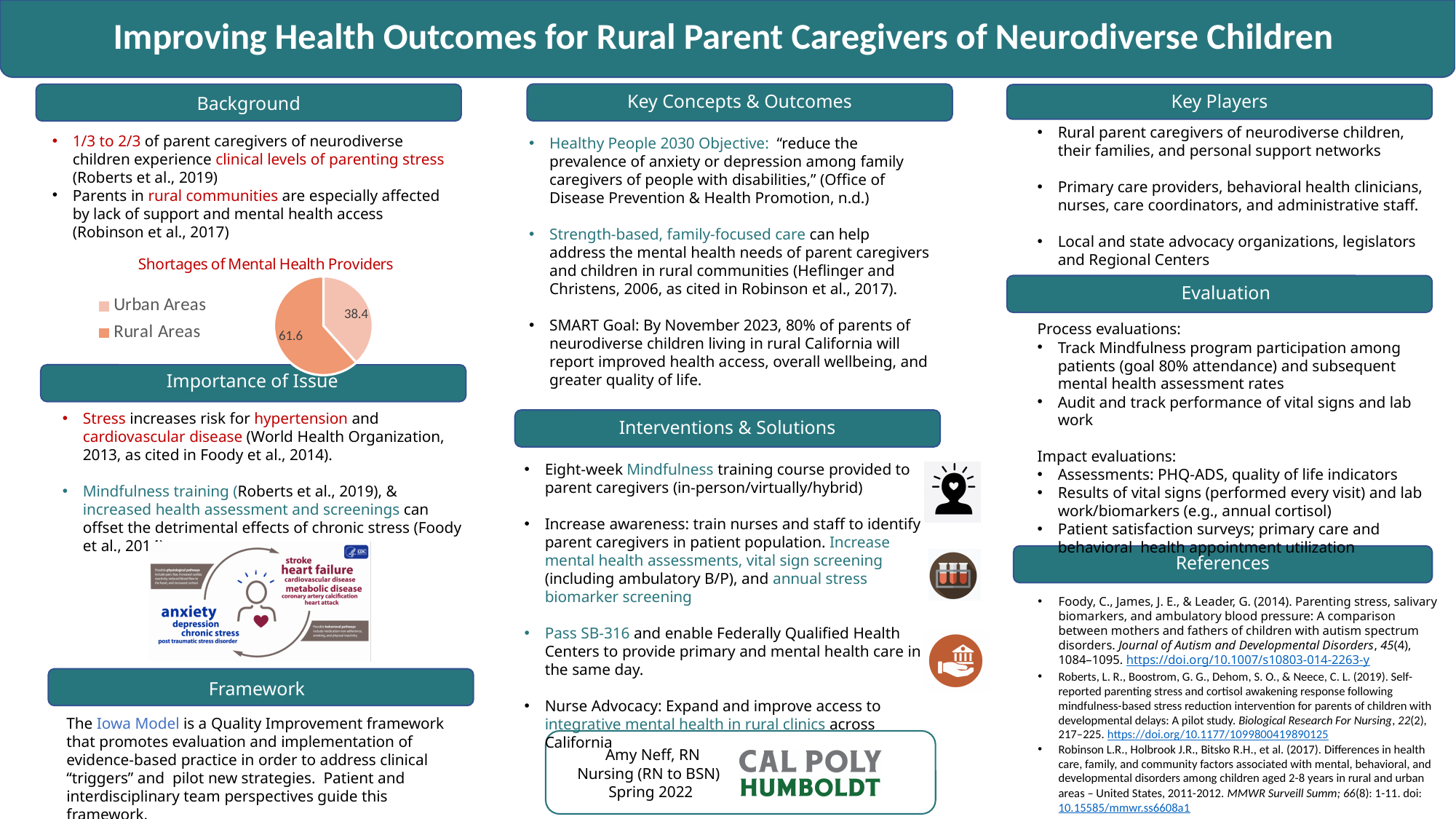
In the "Shortages of Mental Health Providers" pie chart, what is the difference between the Rural Areas value and the Urban Areas value? 23.2 What is the total of the two values shown in the "Shortages of Mental Health Providers" pie chart? 100 In the "Shortages of Mental Health Providers" pie chart, is the value for Rural Areas larger or smaller than the value for Urban Areas? larger In the "Shortages of Mental Health Providers" pie chart, what is the value for Urban Areas? 38.4 Which legend entry in the "Shortages of Mental Health Providers" pie chart is shown in the darker orange colour? Rural Areas What is the title of the pie chart on the slide? Shortages of Mental Health Providers How many entries does the legend of the "Shortages of Mental Health Providers" pie chart list? 2 What kind of chart is shown under the heading "Shortages of Mental Health Providers"? pie chart Which category has the smallest slice in the "Shortages of Mental Health Providers" pie chart? Urban Areas In the "Shortages of Mental Health Providers" pie chart, what is the value for Rural Areas? 61.6 Which category has the largest slice in the "Shortages of Mental Health Providers" pie chart? Rural Areas How many slices does the "Shortages of Mental Health Providers" pie chart have? 2